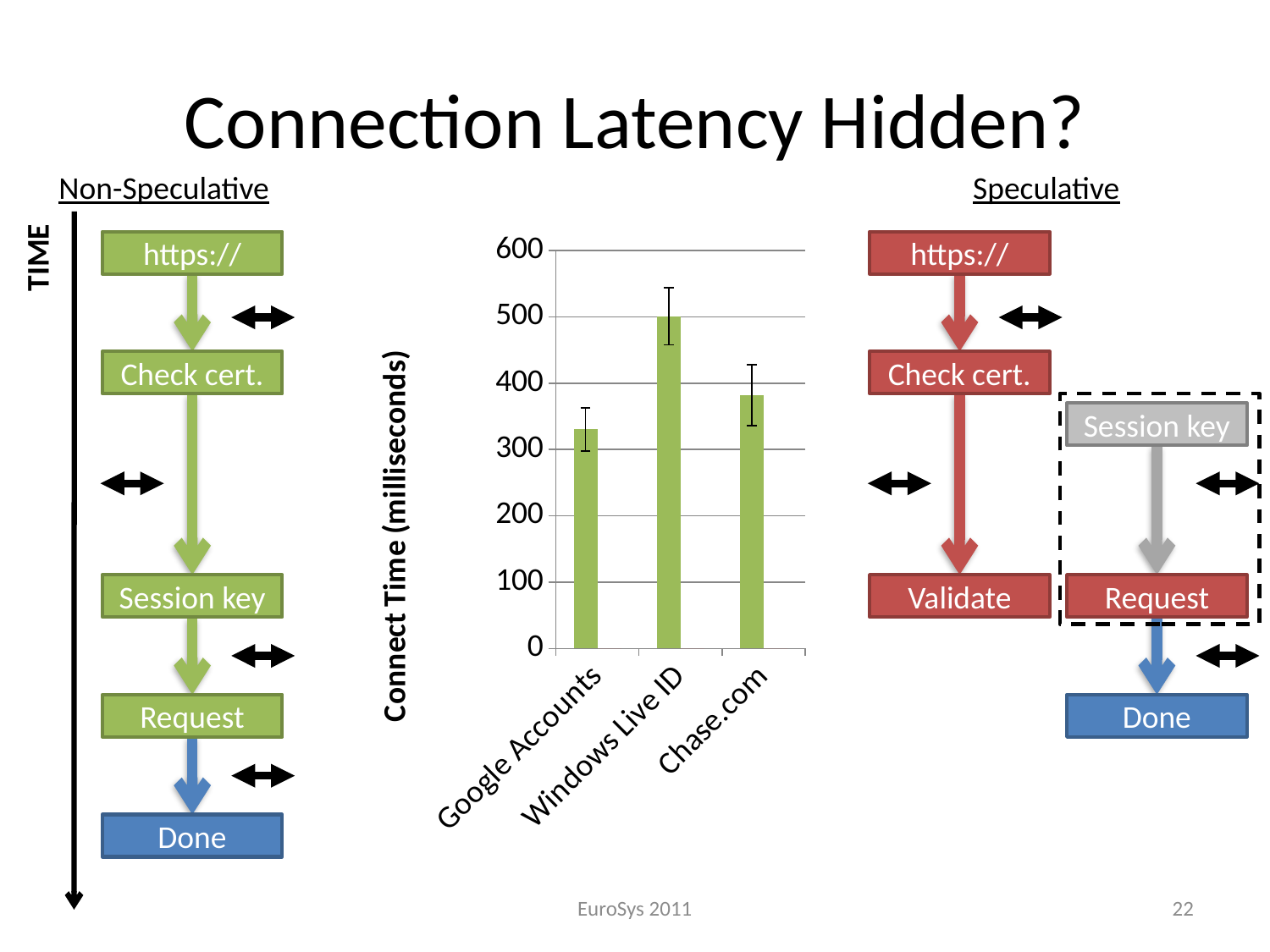
What is the highest value shown on the y axis of the bar chart? 600 Is the connect time for Chase.com greater or less than 300? greater Which category has the lowest connect time in the bar chart? Google Accounts Is the connect time for Google Accounts greater or less than 400? less Which category has the highest connect time in the bar chart? Windows Live ID What kind of chart is shown in the middle of the slide? bar chart What is the label of the y axis of the bar chart? Connect Time (milliseconds) Is the connect time for Windows Live ID greater or less than 400? greater In the bar chart, which has the larger connect time, Windows Live ID or Chase.com? Windows Live ID In the bar chart, which has the larger connect time, Chase.com or Google Accounts? Chase.com How many categories are plotted on the x axis of the bar chart? 3